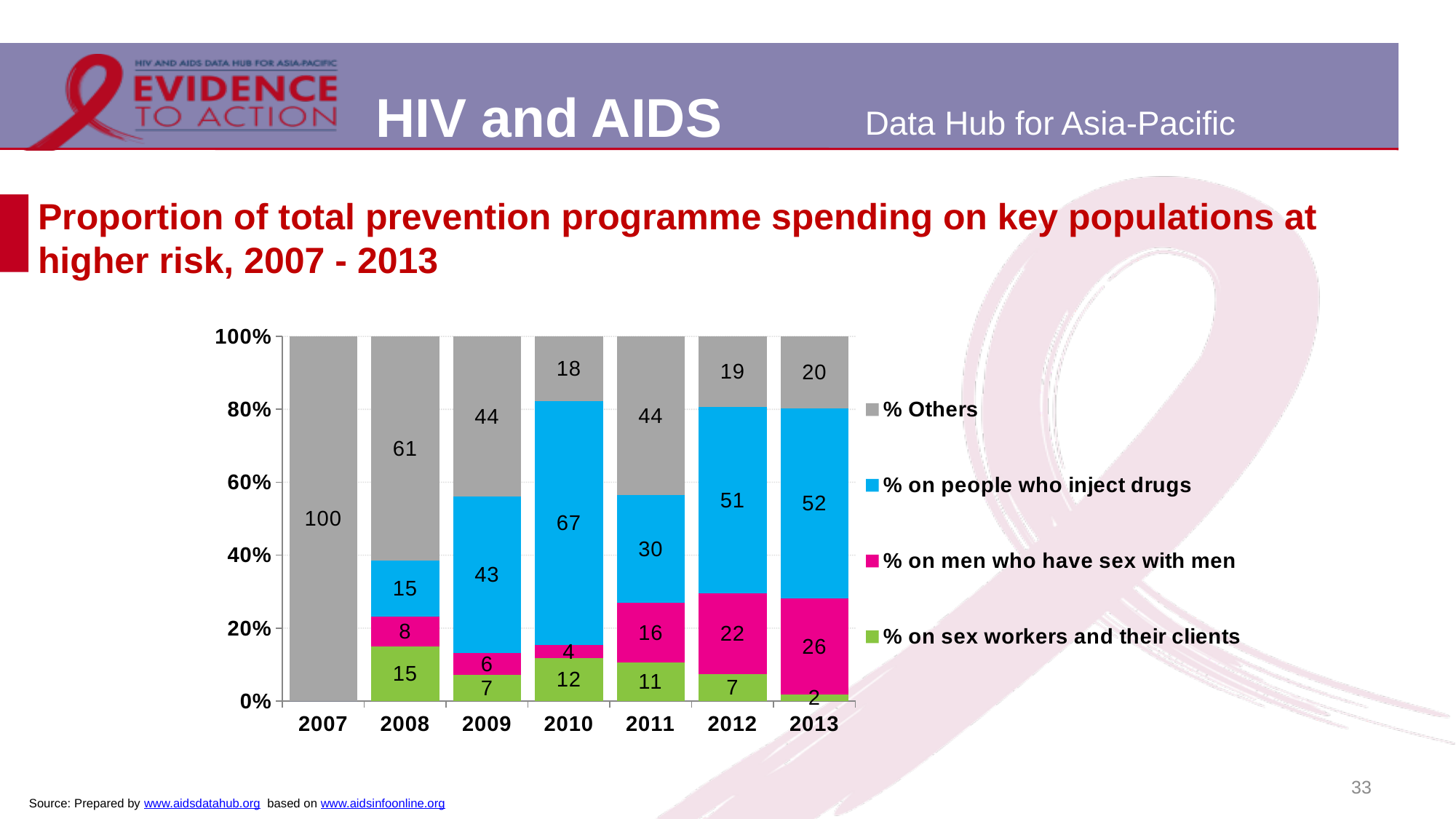
How many years are shown on the x axis? 7 Which is larger, the % Others value for 2009 or for 2012? 2009 In which year is the value for % on sex workers and their clients lowest? 2013 What is the value for % on sex workers and their clients in 2013? 2 What kind of chart is shown on the slide? Stacked bar chart What is the value for % on men who have sex with men in 2012? 22 What is the difference between the % on people who inject drugs values for 2013 and 2008? 37 What is the value for % on people who inject drugs in 2010? 67 Does the value for % on people who inject drugs rise or fall from 2011 to 2013? Rise In which year is the value for % on men who have sex with men highest? 2013 How many series does the legend list? 4 What is the value for % Others in 2008? 61